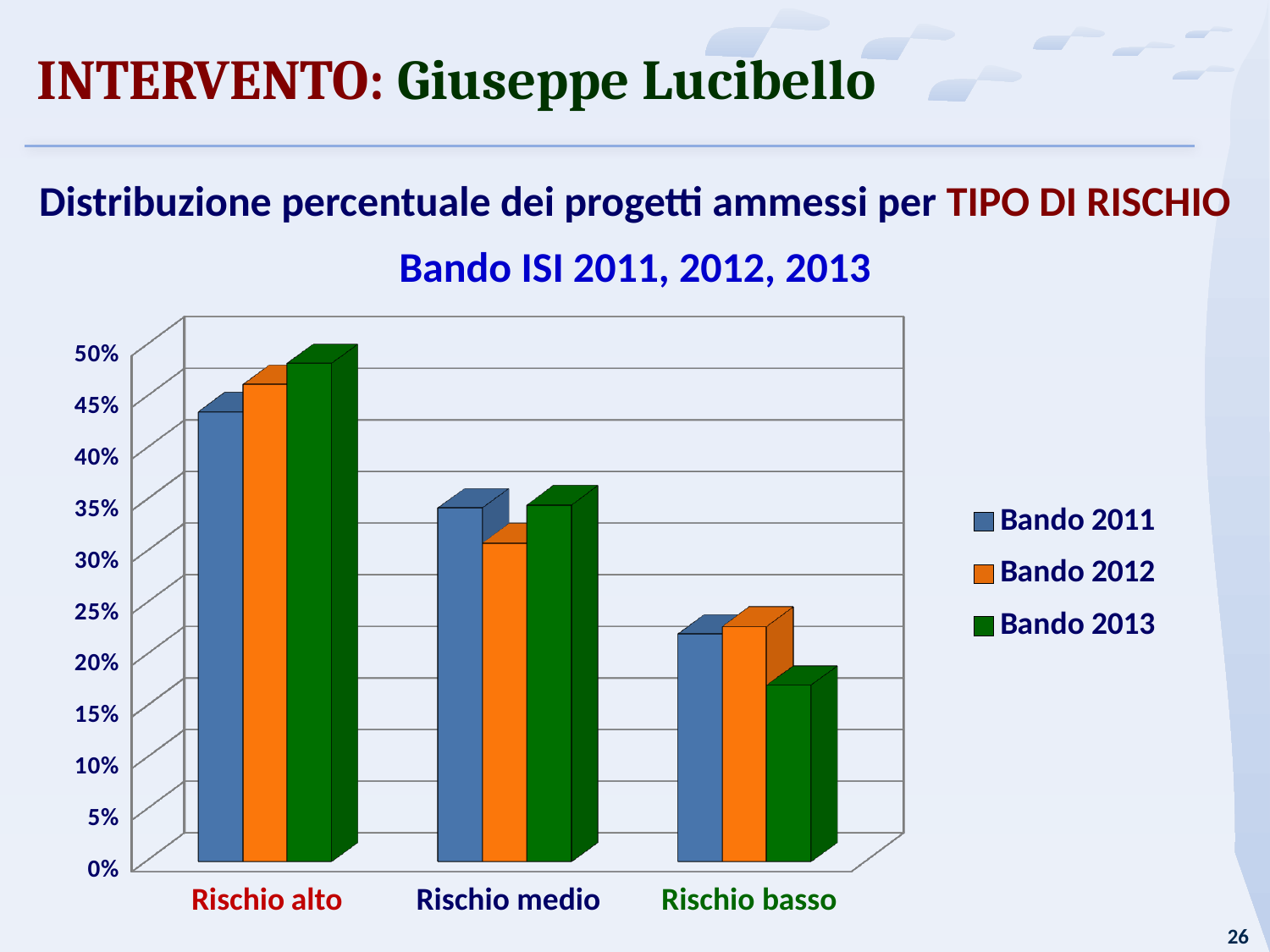
For Rischio alto, which Bando has the highest value? Bando 2013 Which risk category has the highest bars in the chart? Rischio alto In Rischio basso, which is larger: the value for Bando 2012 or for Bando 2013? Bando 2012 What are the three entries listed in the chart legend? Bando 2011, Bando 2012, Bando 2013 Is the value for Bando 2012 in Rischio medio greater or less than 35%? less How many risk categories are shown on the x axis of the chart? 3 How many series does the chart legend list? 3 Is the value for Bando 2013 in Rischio basso greater or less than 20%? less Is the value for Bando 2013 in Rischio alto greater or less than 45%? greater For Rischio basso, which Bando has the lowest value? Bando 2013 What kind of chart is shown on the slide? bar chart For Rischio medio, which Bando has the lowest value? Bando 2012